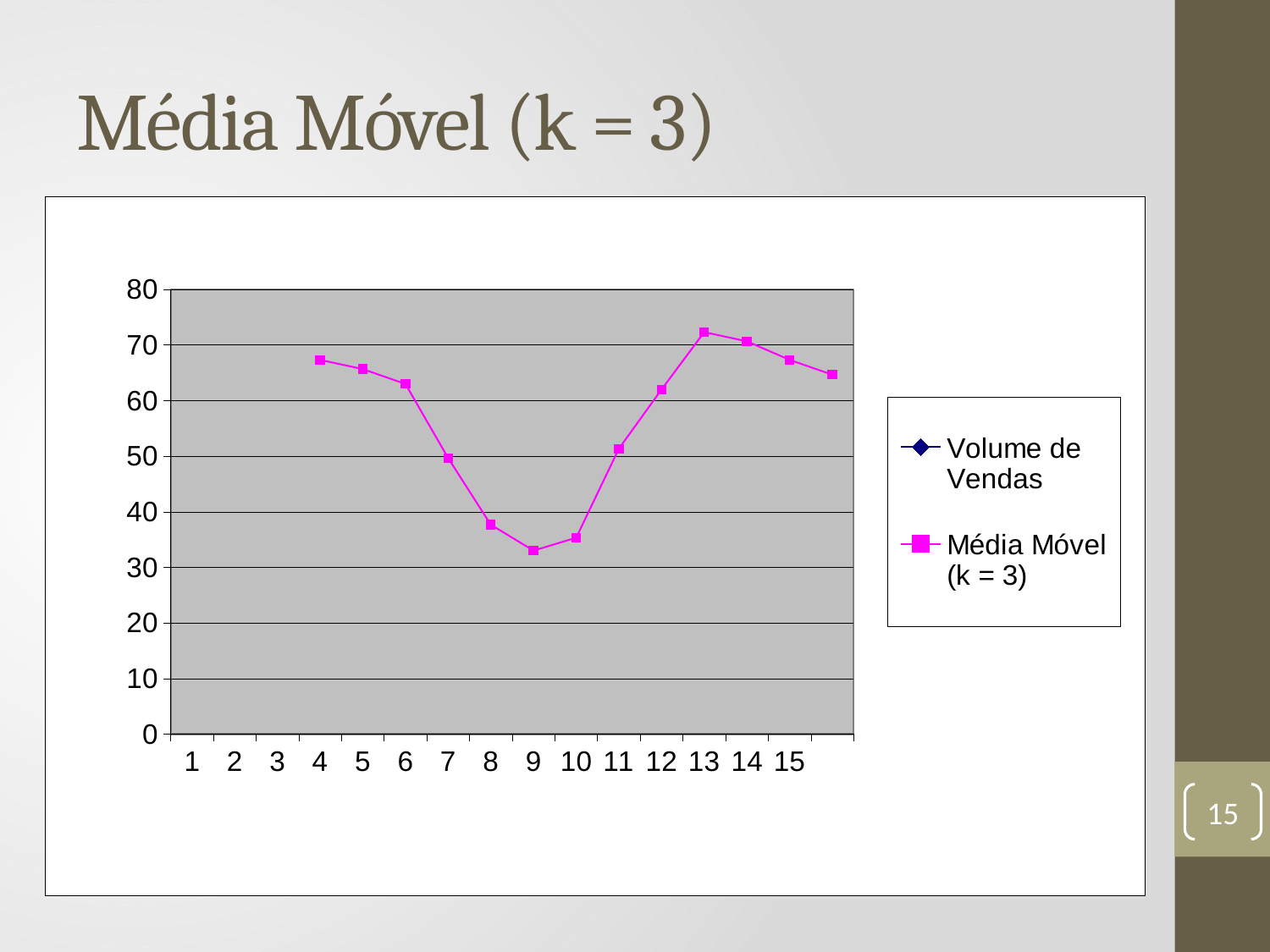
How many series does the legend list? 2 Is the Média Móvel (k = 3) value at position 4 greater or less than 60? greater Which is larger, the Média Móvel (k = 3) value at position 4 or at position 9? position 4 Does the Média Móvel (k = 3) line rise or fall from position 4 to position 9? fall Is the Média Móvel (k = 3) value at position 12 greater or less than 60? greater At which x-axis position does the Média Móvel (k = 3) line reach its highest value? 13 What are the two series named in the legend? Volume de Vendas and Média Móvel (k = 3) Is the Média Móvel (k = 3) value at position 9 greater or less than 40? less What colour is the Média Móvel (k = 3) line? magenta What kind of chart is shown on the slide? line chart At which x-axis position does the Média Móvel (k = 3) line reach its lowest value? 9